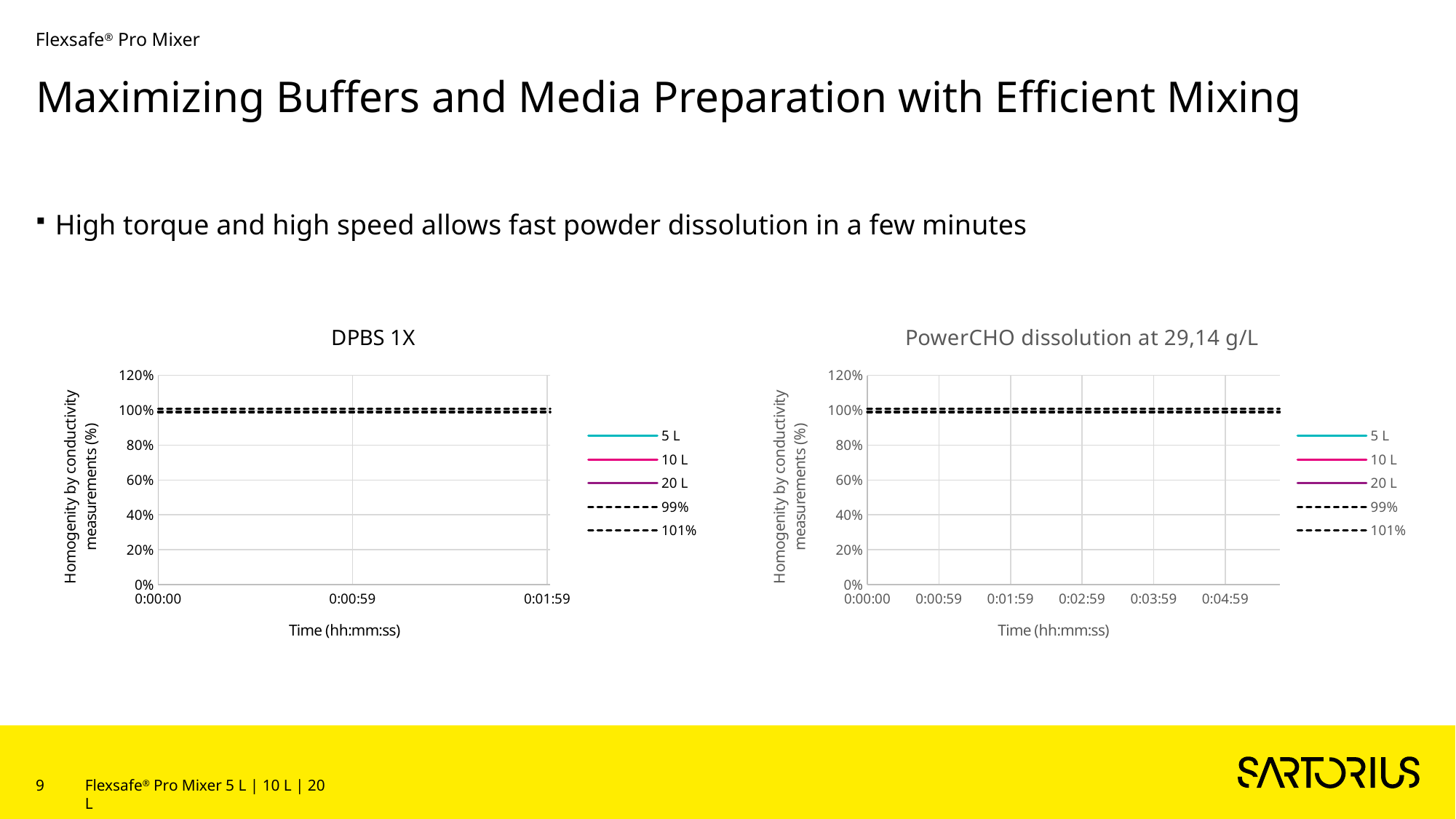
How many series does the legend of the PowerCHO dissolution at 29,14 g/L chart list? 5 In the PowerCHO dissolution at 29,14 g/L chart, is the dashed 101% reference line greater or less than 120%? less What is the x-axis label of the DPBS 1X chart? Time (hh:mm:ss) What is the last time tick labelled on the x axis of the DPBS 1X chart? 0:01:59 How many time ticks are labelled on the x axis of the PowerCHO dissolution at 29,14 g/L chart? 6 In the DPBS 1X chart, is the dashed 99% reference line greater or less than 80%? greater How many time ticks are labelled on the x axis of the DPBS 1X chart? 3 What is the title of the chart on the right of the slide? PowerCHO dissolution at 29,14 g/L What is the last time tick labelled on the x axis of the PowerCHO dissolution at 29,14 g/L chart? 0:04:59 What kind of chart is the PowerCHO dissolution at 29,14 g/L chart? line chart What kind of chart is the DPBS 1X chart? line chart How many series does the legend of the DPBS 1X chart list? 5